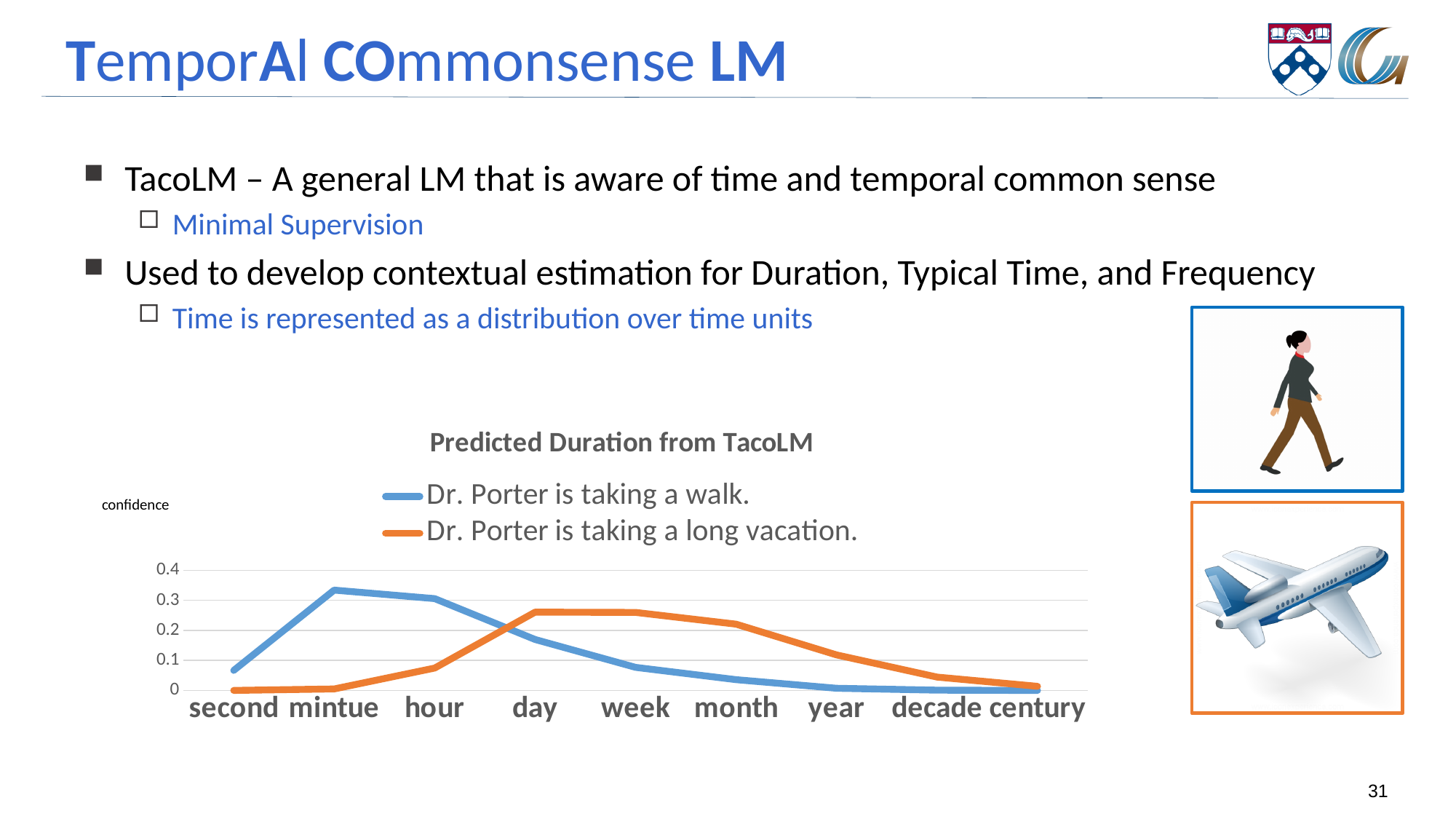
How many time-unit categories are shown on the x axis of the chart? 9 Is the value for "Dr. Porter is taking a long vacation." at day greater or less than 0.2? greater What is the title of the chart? Predicted Duration from TacoLM At mintue, which series has the higher value: "Dr. Porter is taking a walk." or "Dr. Porter is taking a long vacation."? Dr. Porter is taking a walk. Does the value for "Dr. Porter is taking a walk." rise or fall from hour to year? fall Is the value for "Dr. Porter is taking a walk." at mintue greater or less than 0.3? greater How many series does the chart's legend list? 2 Is the value for "Dr. Porter is taking a walk." at week greater or less than 0.1? less What label is shown on the vertical axis of the chart? confidence At month, which series has the higher value: "Dr. Porter is taking a walk." or "Dr. Porter is taking a long vacation."? Dr. Porter is taking a long vacation. What kind of chart is shown on the slide? line chart